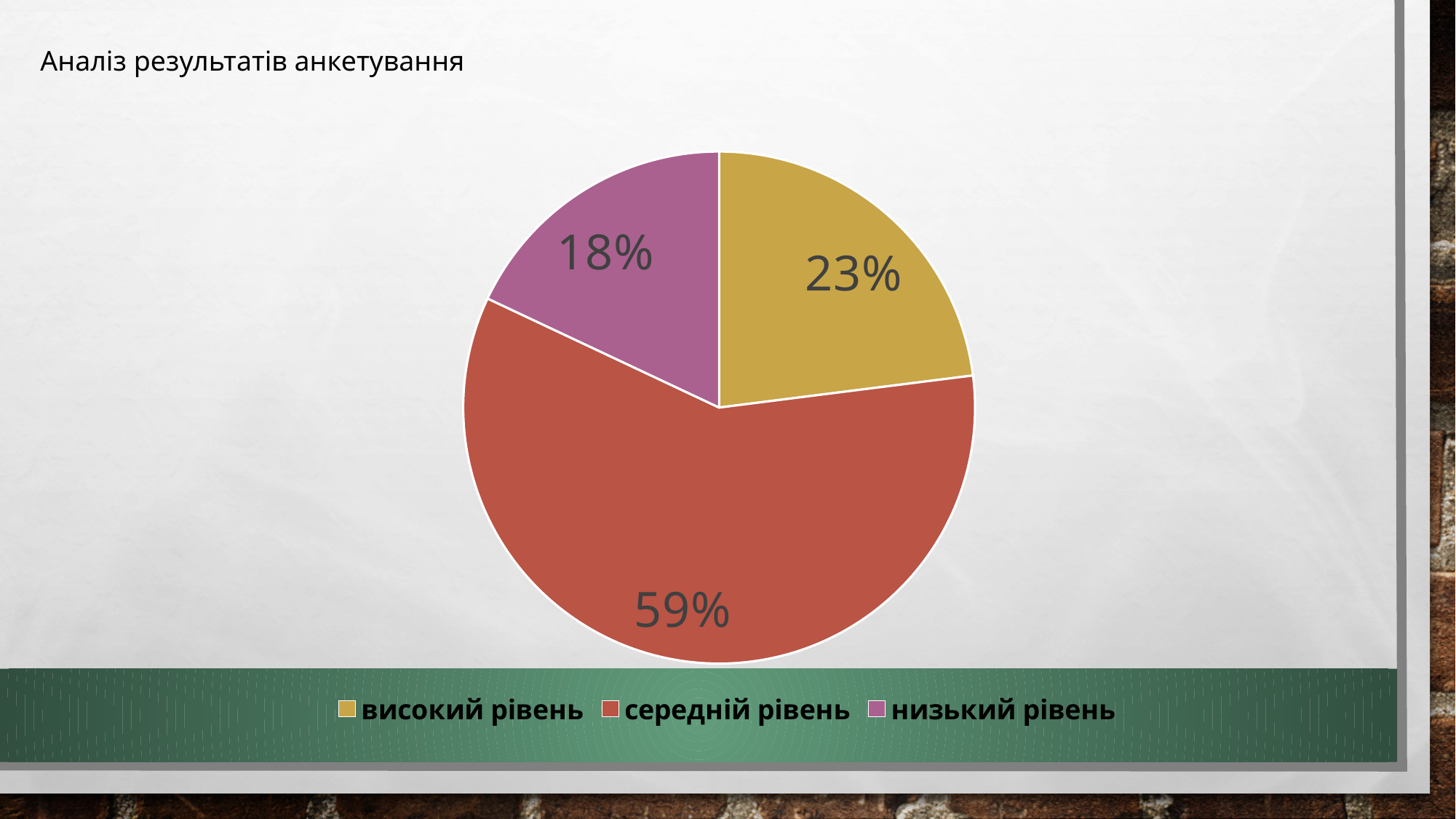
Which is larger, the slice for високий рівень or the slice for низький рівень? високий рівень What percentage is shown for високий рівень? 23% Which category has the largest slice of the pie? середній рівень What is the difference in percentage points between середній рівень and високий рівень? 36 What percentage is shown for низький рівень? 18% What is the difference in percentage points between високий рівень and низький рівень? 5 How many slices does the pie chart have? 3 What colour is the slice for середній рівень? red What kind of chart is shown on the slide? pie chart Which category has the smallest slice of the pie? низький рівень What percentage is shown for середній рівень? 59% What is the title of the slide? Аналіз результатів анкетування